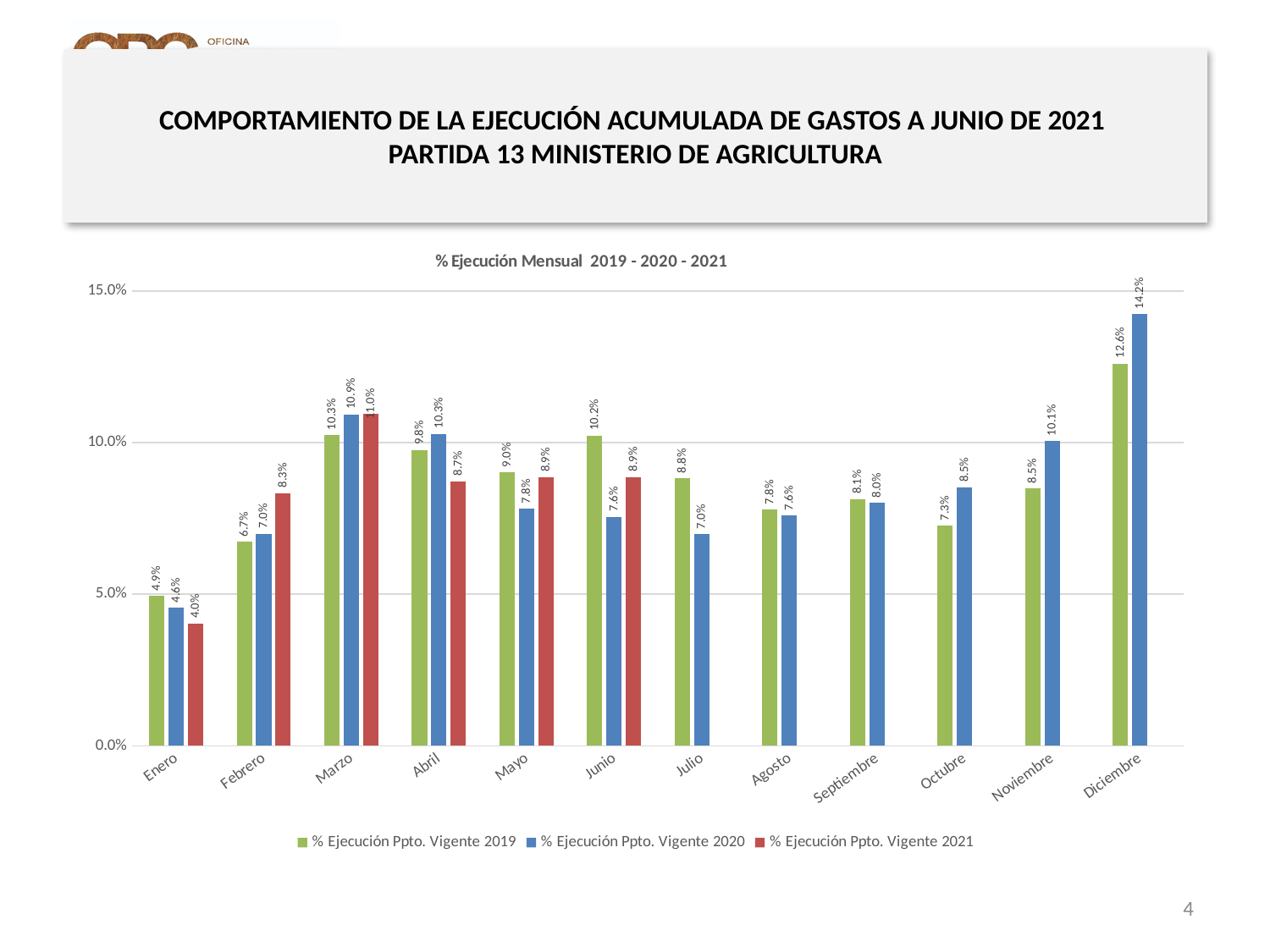
What is the value for % Ejecución Ppto. Vigente 2020 in Diciembre? 14.2% How many months are shown on the x axis? 12 What is the value for % Ejecución Ppto. Vigente 2021 in Enero? 4.0% Is the value for % Ejecución Ppto. Vigente 2021 in Marzo greater or less than 10.0%? greater How many series does the legend list? 3 What is the title of the chart? % Ejecución Mensual 2019 - 2020 - 2021 Which is larger in Abril: the 2020 value or the 2021 value? 2020 (10.3%) What is the value for % Ejecución Ppto. Vigente 2019 in Junio? 10.2% Which month has the highest value for % Ejecución Ppto. Vigente 2019? Diciembre Which month has the lowest value for % Ejecución Ppto. Vigente 2020? Enero What is the difference between the 2020 and 2019 values in Diciembre? 1.6% What kind of chart is shown on the slide? Bar chart